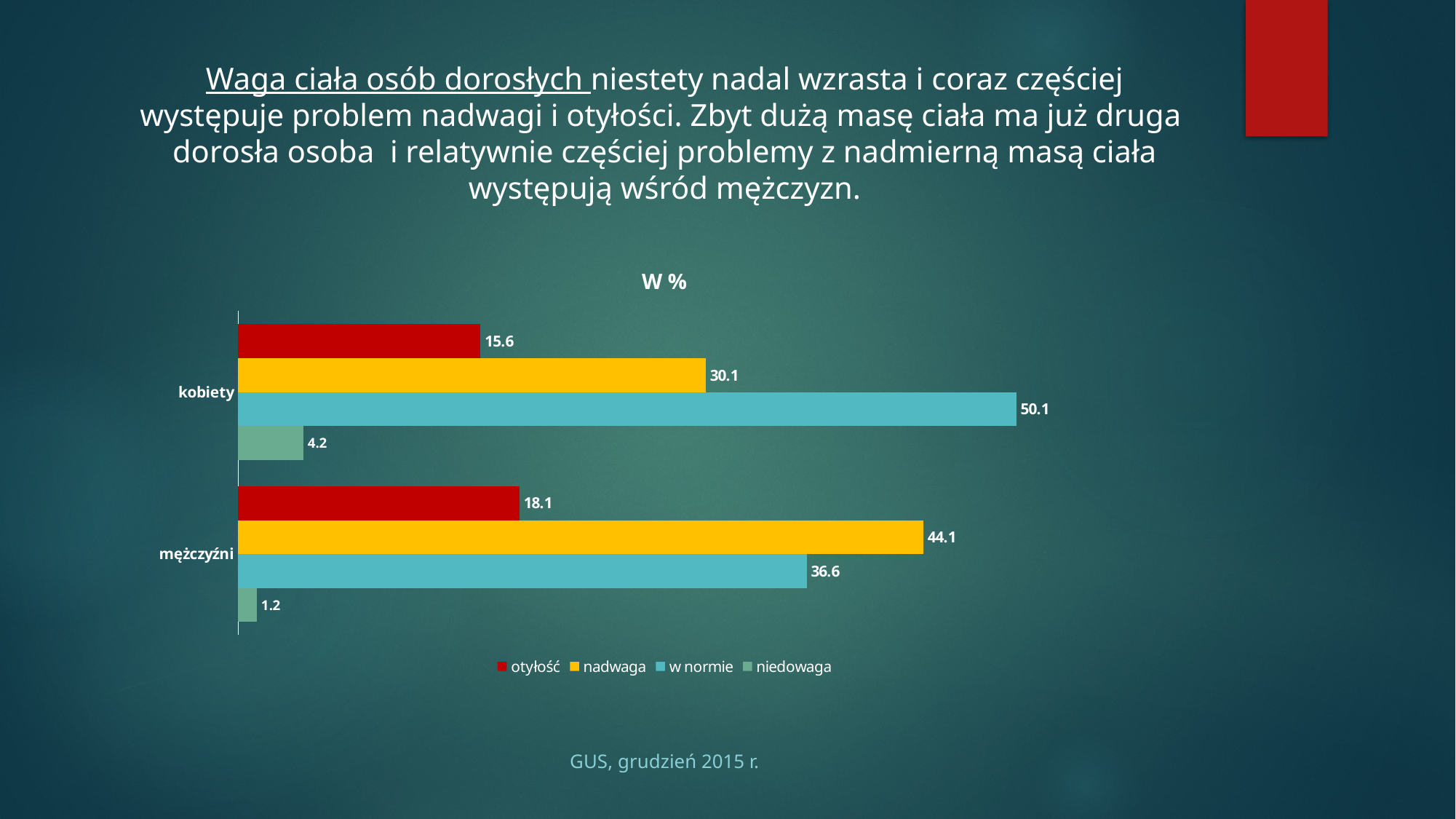
How many series does the legend list? 4 What is the value for 'otyłość' for 'mężczyźni'? 18.1 Which series has the lowest value for 'mężczyźni'? niedowaga What kind of chart is shown on the slide? bar chart Which is larger: 'otyłość' for 'kobiety' or 'otyłość' for 'mężczyźni'? mężczyźni What is the value for 'nadwaga' for 'kobiety'? 30.1 What is the difference between the 'nadwaga' values for 'mężczyźni' and 'kobiety'? 14 What is the title of the chart? W % Which series has the highest value for 'kobiety'? w normie What is the value for 'w normie' for 'mężczyźni'? 36.6 What is the value for 'niedowaga' for 'kobiety'? 4.2 How many categories are shown on the chart? 2